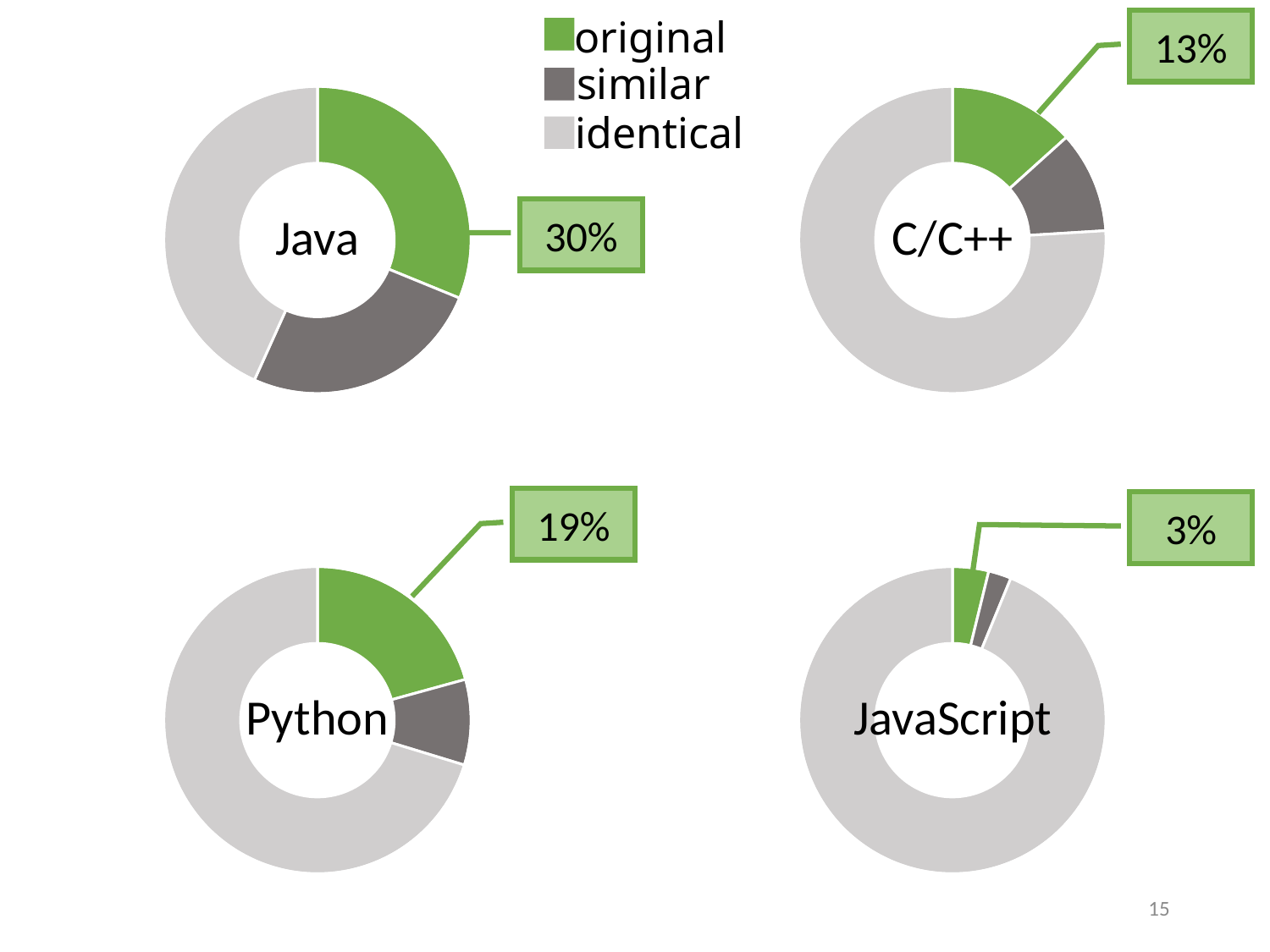
How much larger is the original share in the Java chart than in the C/C++ chart? 17% In the Java chart, what share of the donut is labelled as original? 30% Across the four charts, which language has the highest original share? Java What kind of chart is used for each of the four languages on the slide? Pie (donut) chart Across the four charts, which language has the lowest original share? JavaScript Which has a larger original share, the Python chart or the C/C++ chart? Python In the Python chart, what percentage is shown for the original slice? 19% In the JavaScript chart, which category takes up the largest part of the donut? identical How many categories does the legend list? 3 In the JavaScript chart, what percentage is shown for the original slice? 3% Which colour represents the original category in the legend? Green In the C/C++ chart, what percentage is shown for the original slice? 13%